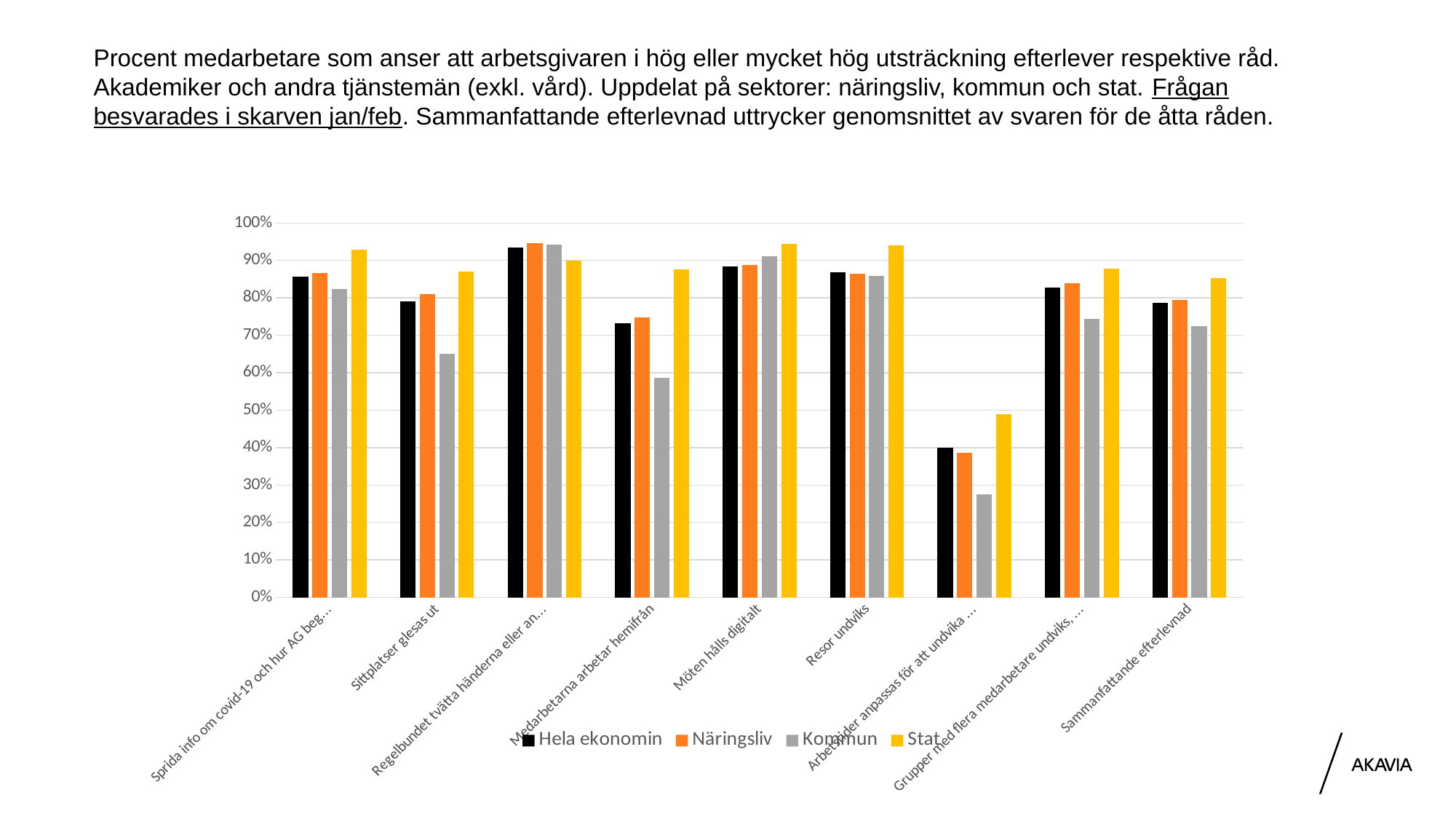
How many categories are shown along the x axis? 9 In the category "Medarbetarna arbetar hemifrån", which is larger: the value for Stat or the value for Kommun? Stat Is the value for Kommun in the category "Medarbetarna arbetar hemifrån" greater or less than 60%? less Which series is shown in yellow in the legend? Stat In the category "Sammanfattande efterlevnad", which series has the lowest value? Kommun Which series is shown in grey in the legend? Kommun What kind of chart is shown on the slide? bar chart Is the value for Stat in the category "Möten hålls digitalt" greater or less than 90%? greater Is the value for Kommun in the category "Sittplatser glesas ut" greater or less than 60%? greater How many series does the legend list? 4 In the category "Sammanfattande efterlevnad", which series has the highest value? Stat